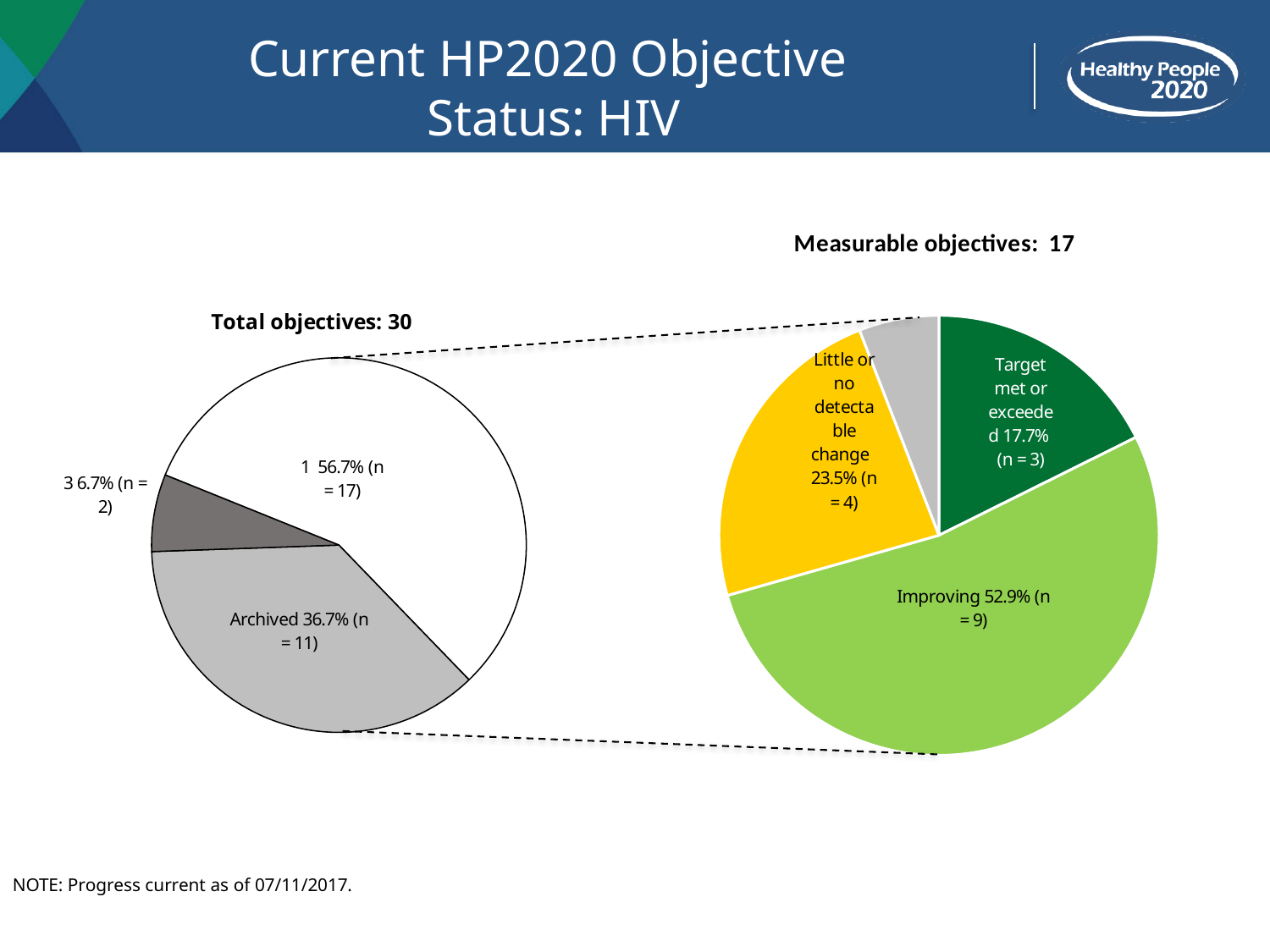
In the "Measurable objectives: 17" chart, what percentage is shown for Improving? 52.9% According to the chart titles, how many total objectives and how many measurable objectives are there? 30 total, 17 measurable How many slices does the "Measurable objectives: 17" pie chart have? 4 In the "Measurable objectives: 17" chart, which slice is the largest? Improving In the "Total objectives: 30" chart, what percentage is shown for Archived? 36.7% In the "Measurable objectives: 17" chart, how many more objectives are Improving than Target met or exceeded? 6 In the "Measurable objectives: 17" chart, how many objectives (n) show Little or no detectable change? 4 How many slices does the "Total objectives: 30" pie chart have? 3 In the "Measurable objectives: 17" chart, how many objectives (n) are in the Target met or exceeded slice? 3 What kind of chart is the chart titled "Total objectives: 30"? pie chart In the "Measurable objectives: 17" chart, which is larger: Little or no detectable change or Target met or exceeded? Little or no detectable change In the "Total objectives: 30" chart, how many objectives (n) are Archived? 11